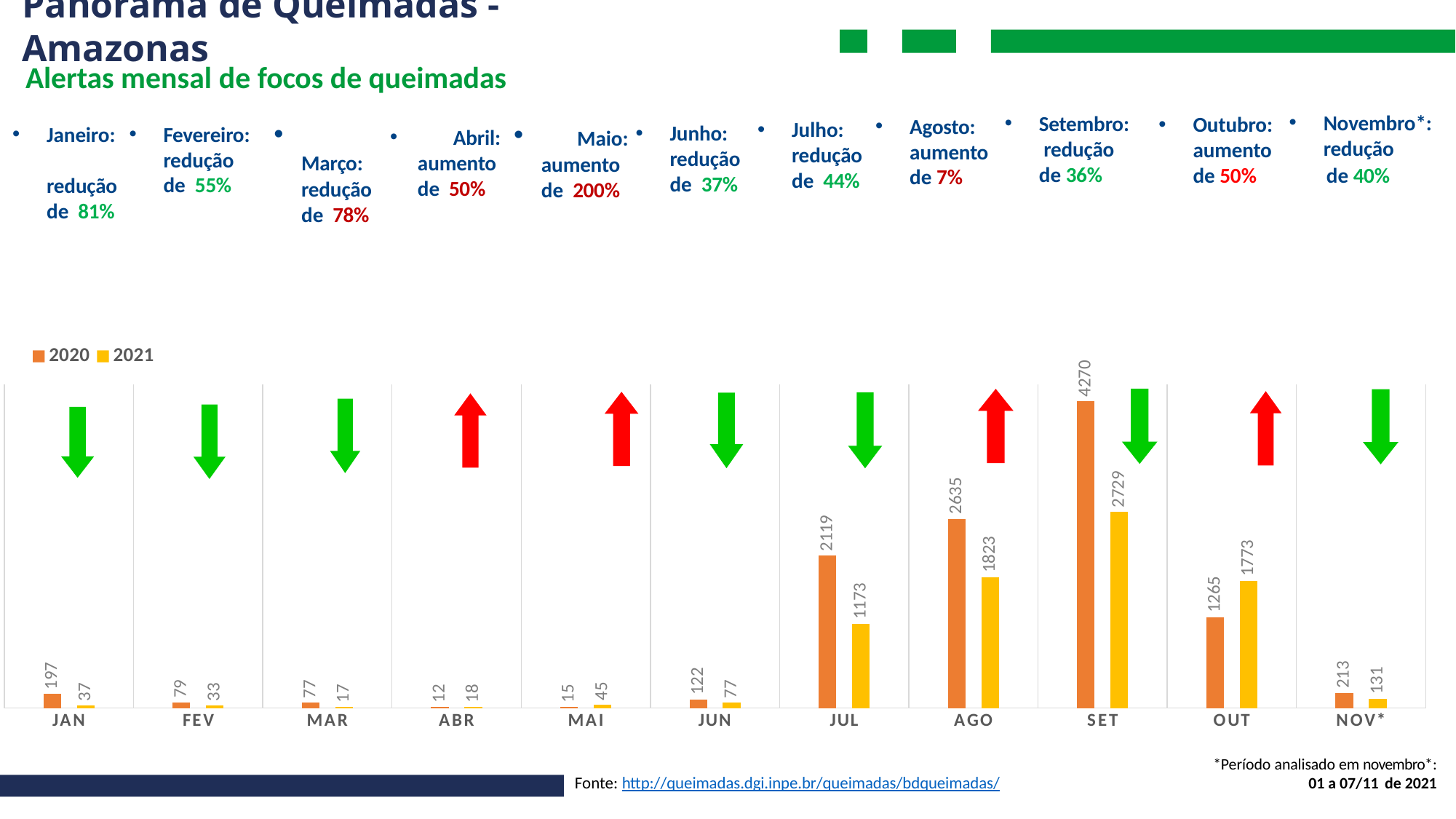
Which month has the lowest value for the 2020 series? ABR Which colour represents the 2021 series in the chart? yellow How many months are shown on the x axis? 11 What is the total of the 2020 and 2021 values in JUL? 3292 What is the value for 2021 in OUT? 1773 How many series does the legend list? 2 What kind of chart is shown on the slide? bar chart Which month has the highest value for the 2021 series? SET In OUT, which series has the larger value, 2020 or 2021? 2021 What is the difference between the 2020 and 2021 values in AGO? 812 What is the value for 2021 in JAN? 37 What is the value for 2020 in SET? 4270